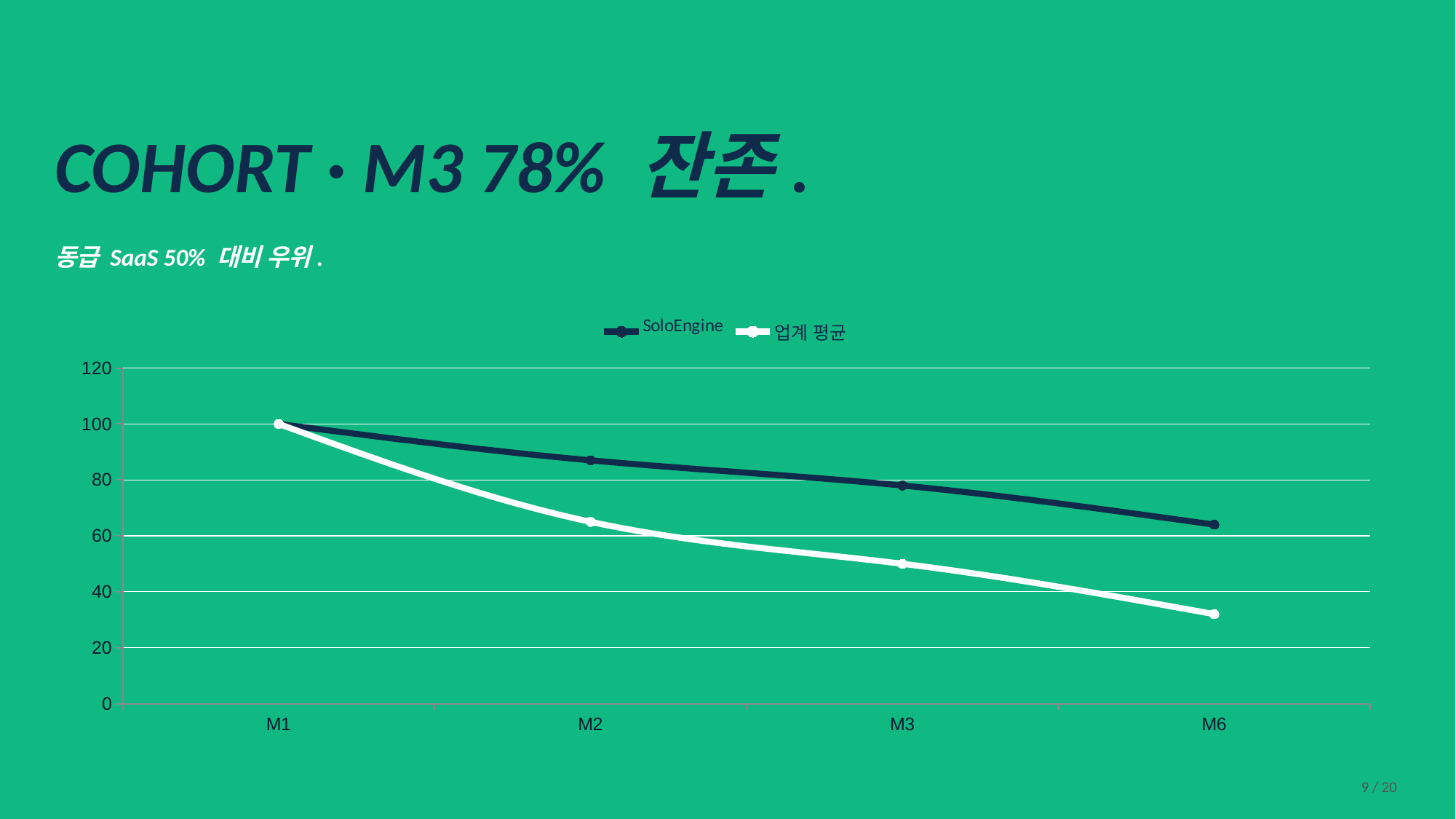
Is the value for SoloEngine at M2 greater or less than 80? greater What kind of chart is shown on the slide? line chart Is the value for SoloEngine at M6 greater or less than 60? greater At M3, which series has the higher value, SoloEngine or 업계 평균? SoloEngine Which series is drawn in white? 업계 평균 How many points are plotted along the x axis for each series? 4 How many series does the legend list? 2 Is the value for 업계 평균 at M2 greater or less than 80? less What is the value for 업계 평균 at M1? 100 Do the values for 업계 평균 rise or fall from M1 to M6? fall What is the value for SoloEngine at M1? 100